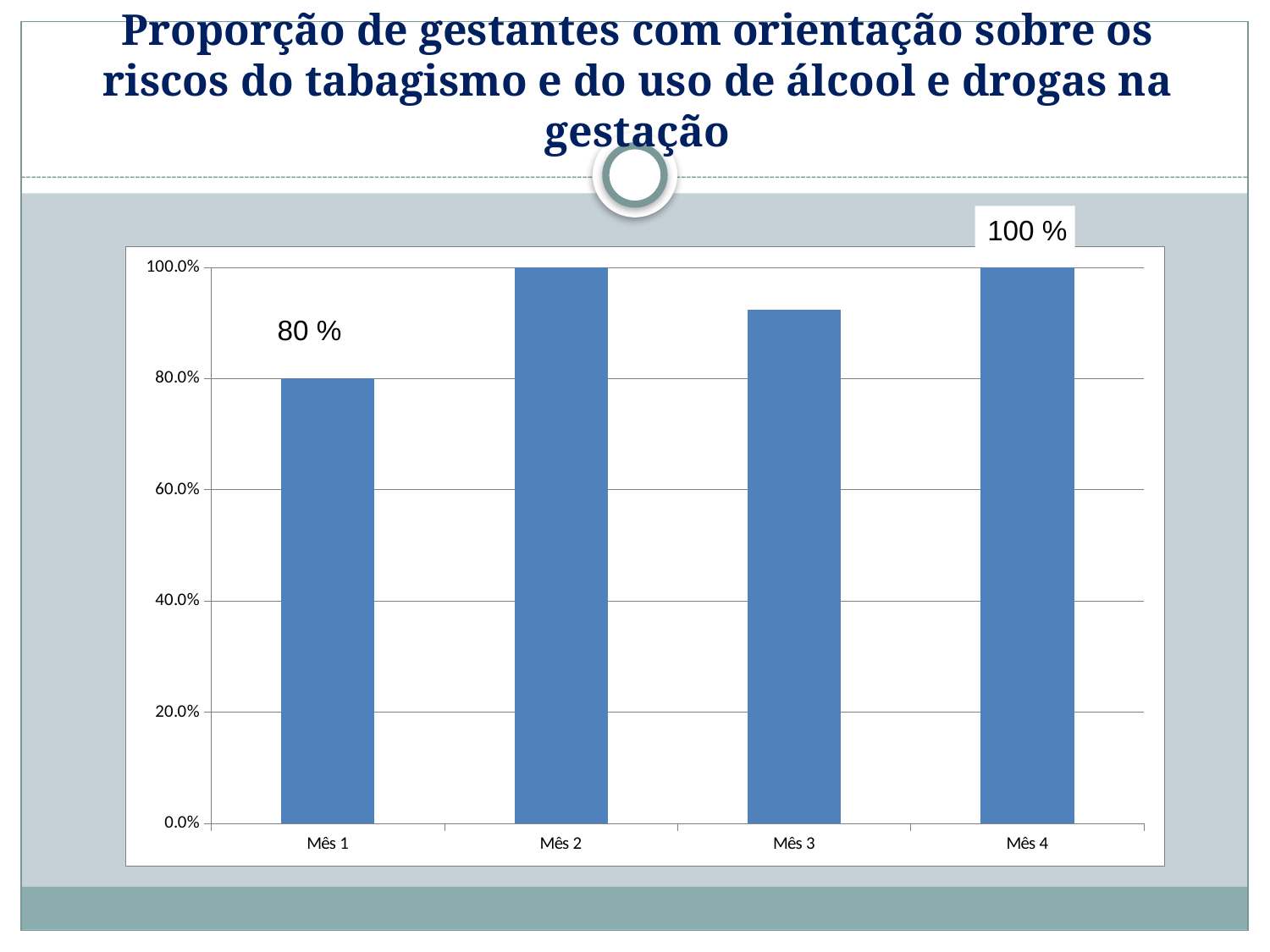
How many months are shown on the x axis? 4 What is the highest value shown on the y axis? 100.0% Which is larger, the value for Mês 2 or the value for Mês 3? Mês 2 Which month has the lowest value? Mês 1 Is the value for Mês 3 greater or less than 100.0%? less What is the value for Mês 2? 100.0% What kind of chart is shown on the slide? bar chart Which is larger, the value for Mês 1 or the value for Mês 3? Mês 3 What is the difference between the value for Mês 4 and the value for Mês 1? 20 % What is the value for Mês 1? 80 % What is the value for Mês 4? 100 % Is the value for Mês 3 greater or less than 80.0%? greater